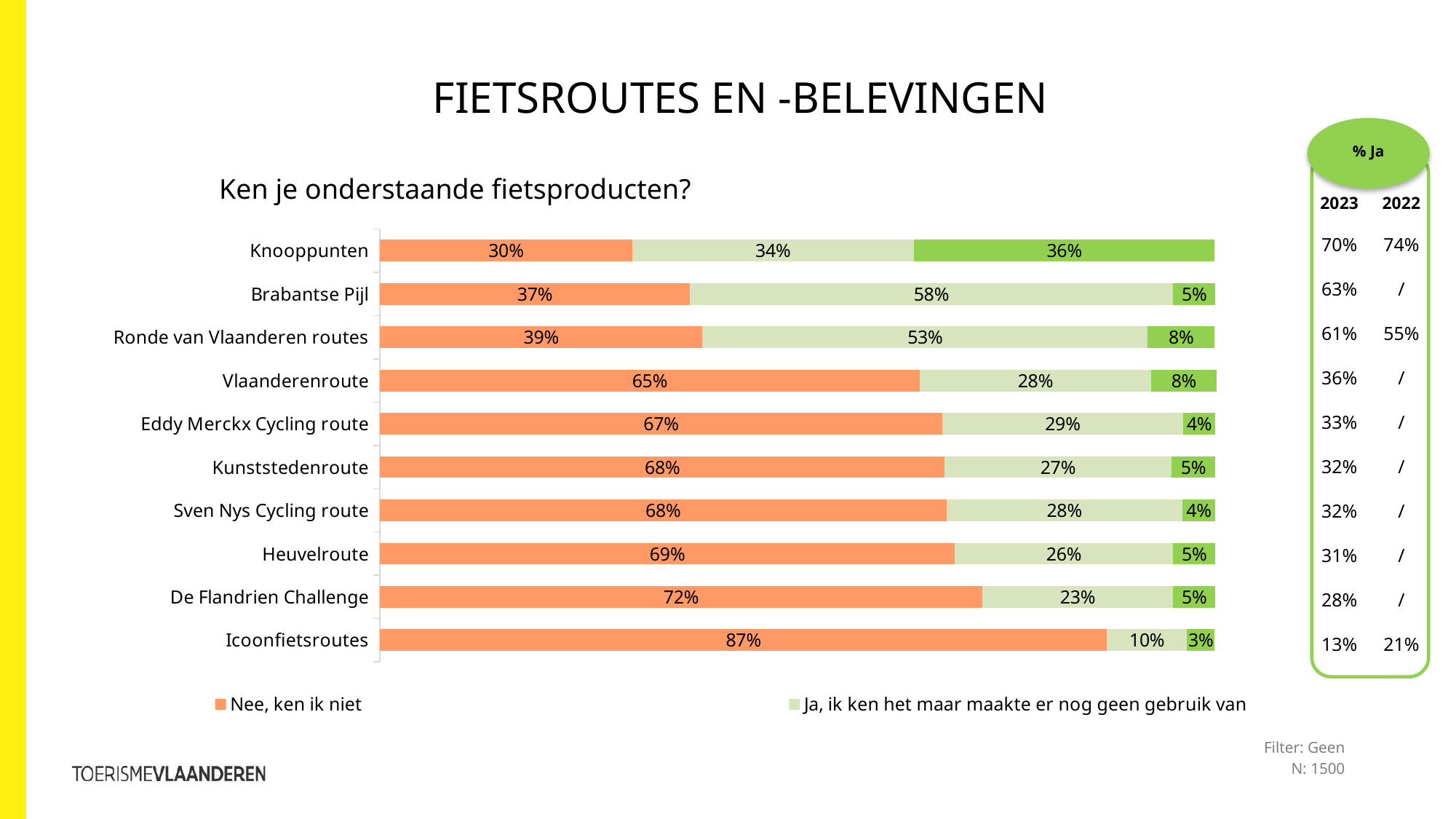
What question is shown as the chart's title? Ken je onderstaande fietsproducten? What is the total of the three segments of the Knooppunten bar? 100% What is the value of the dark green segment for Ronde van Vlaanderen routes? 8% Which category has the lowest "Nee, ken ik niet" percentage? Knooppunten What is the difference between the "Nee, ken ik niet" values for De Flandrien Challenge and Heuvelroute? 3 percentage points Which category has the highest "Nee, ken ik niet" percentage? Icoonfietsroutes What is the "Ja, ik ken het maar maakte er nog geen gebruik van" value for Brabantse Pijl? 58% Which has a larger "Nee, ken ik niet" value: Vlaanderenroute or Ronde van Vlaanderen routes? Vlaanderenroute How many cycling products (categories) are shown in the chart? 10 What percentage of respondents answered "Nee, ken ik niet" for Knooppunten? 30% What is the "Nee, ken ik niet" value for Icoonfietsroutes? 87% What kind of chart is shown on the slide? Stacked bar chart